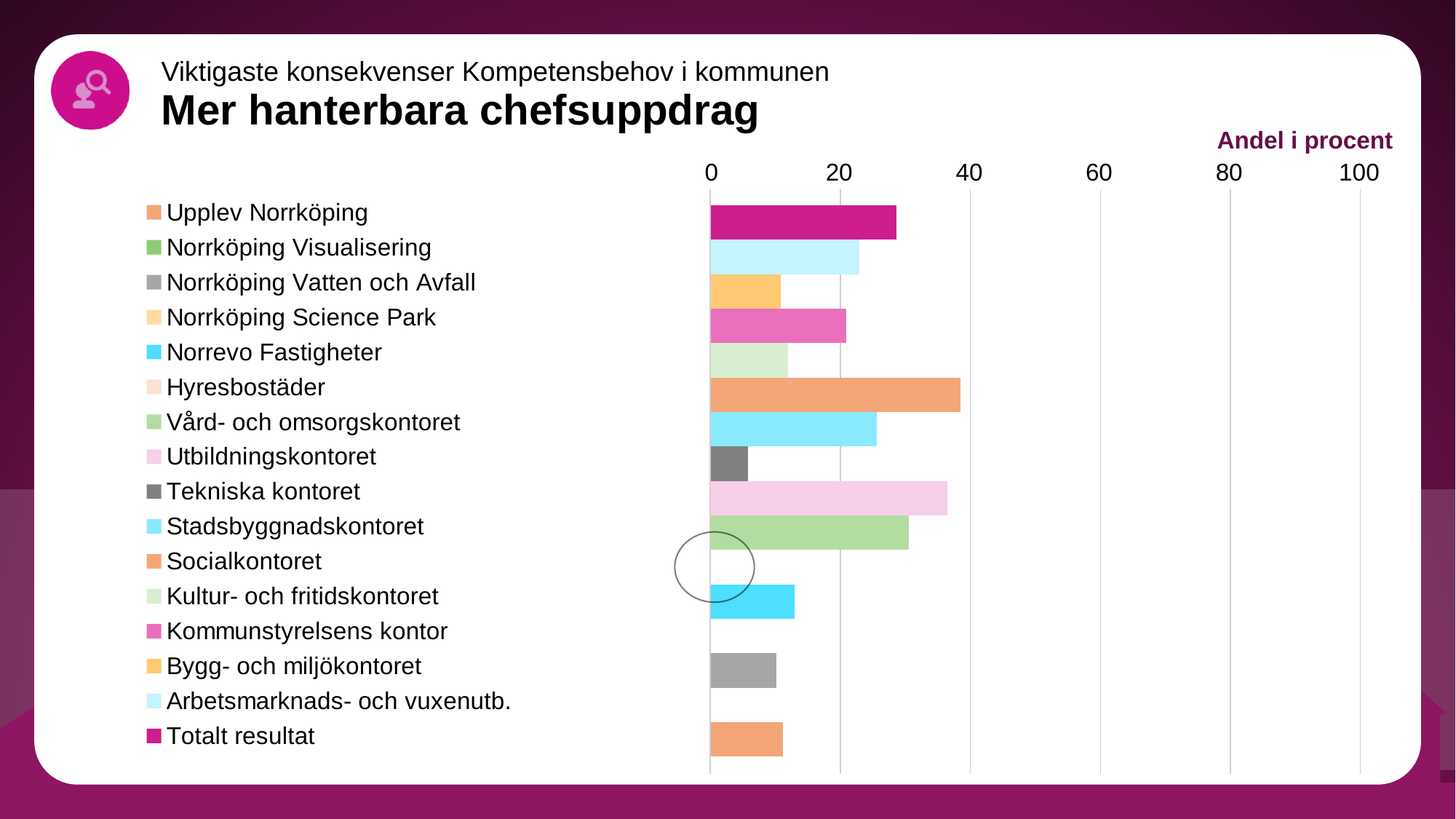
Is the value for Tekniska kontoret greater or less than 20? less What is the main title of the slide above the chart? Mer hanterbara chefsuppdrag Which is larger, the value for Socialkontoret or the value for Kultur- och fritidskontoret? Socialkontoret How many entries does the legend list? 16 Is the value for Norrköping Vatten och Avfall greater or less than 20? less Is the value for Socialkontoret greater or less than 20? greater What kind of chart is shown on the slide? bar chart What is the label shown above the horizontal axis? Andel i procent Which is larger, the value for Totalt resultat or the value for Tekniska kontoret? Totalt resultat